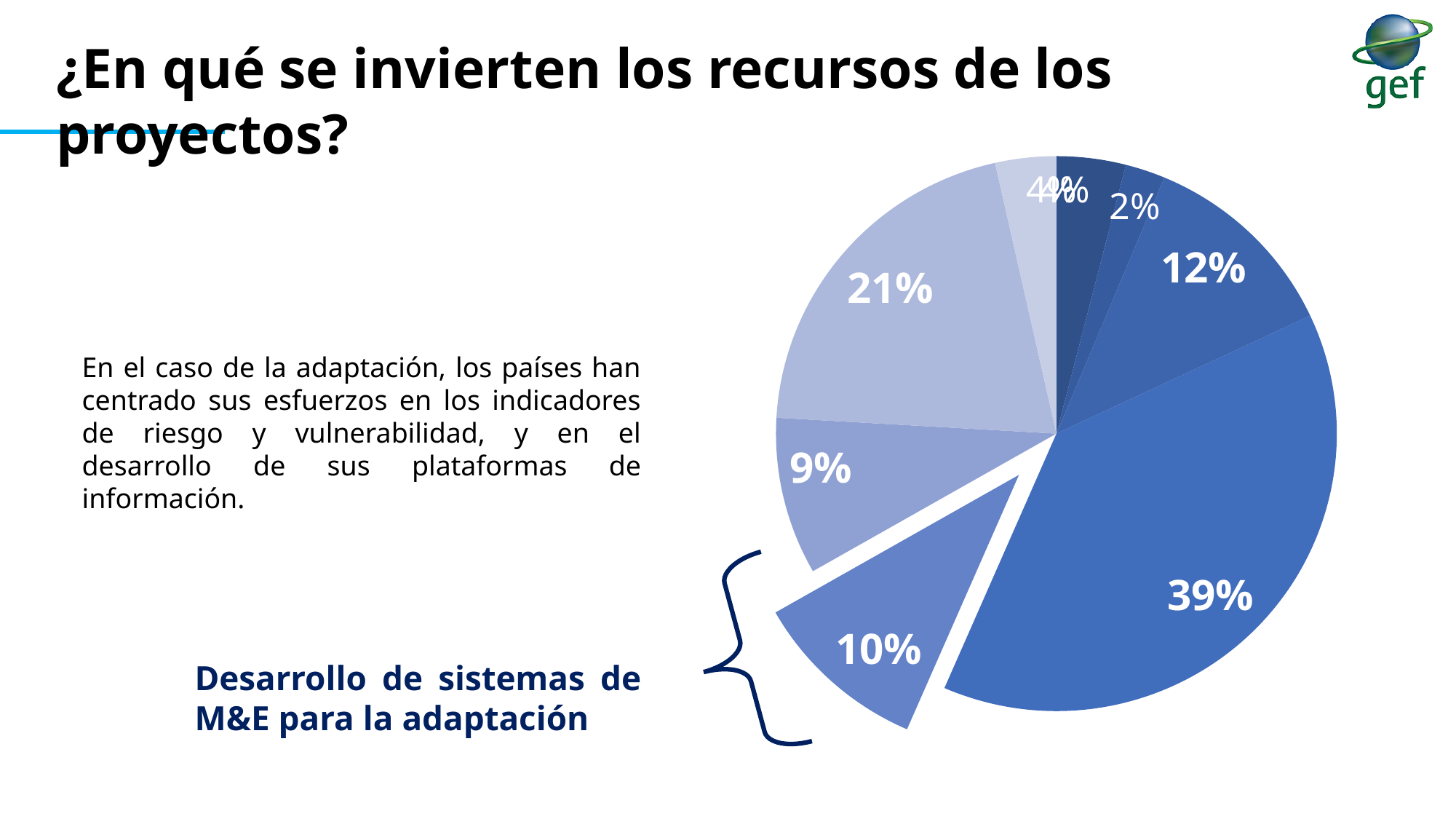
What is the difference in percentage points between the 12% slice and the 9% slice? 3 Which slice of the pie is pulled out (exploded) from the rest? the 10% slice (Desarrollo de sistemas de M&E para la adaptación) Is the largest slice of the pie greater or less than 50% of the total? less What kind of chart is shown on the slide? pie chart What is the difference in percentage points between the 39% slice and the 21% slice? 18 What is the title of the slide containing the pie chart? ¿En qué se invierten los recursos de los proyectos? What share of the pie is the exploded slice labelled 'Desarrollo de sistemas de M&E para la adaptación'? 10% What share of the pie does the largest slice represent? 39% Which is larger, the slice labelled 21% or the slice labelled 12%? 21% What is the combined share of the 39% slice and the 10% exploded slice? 49%